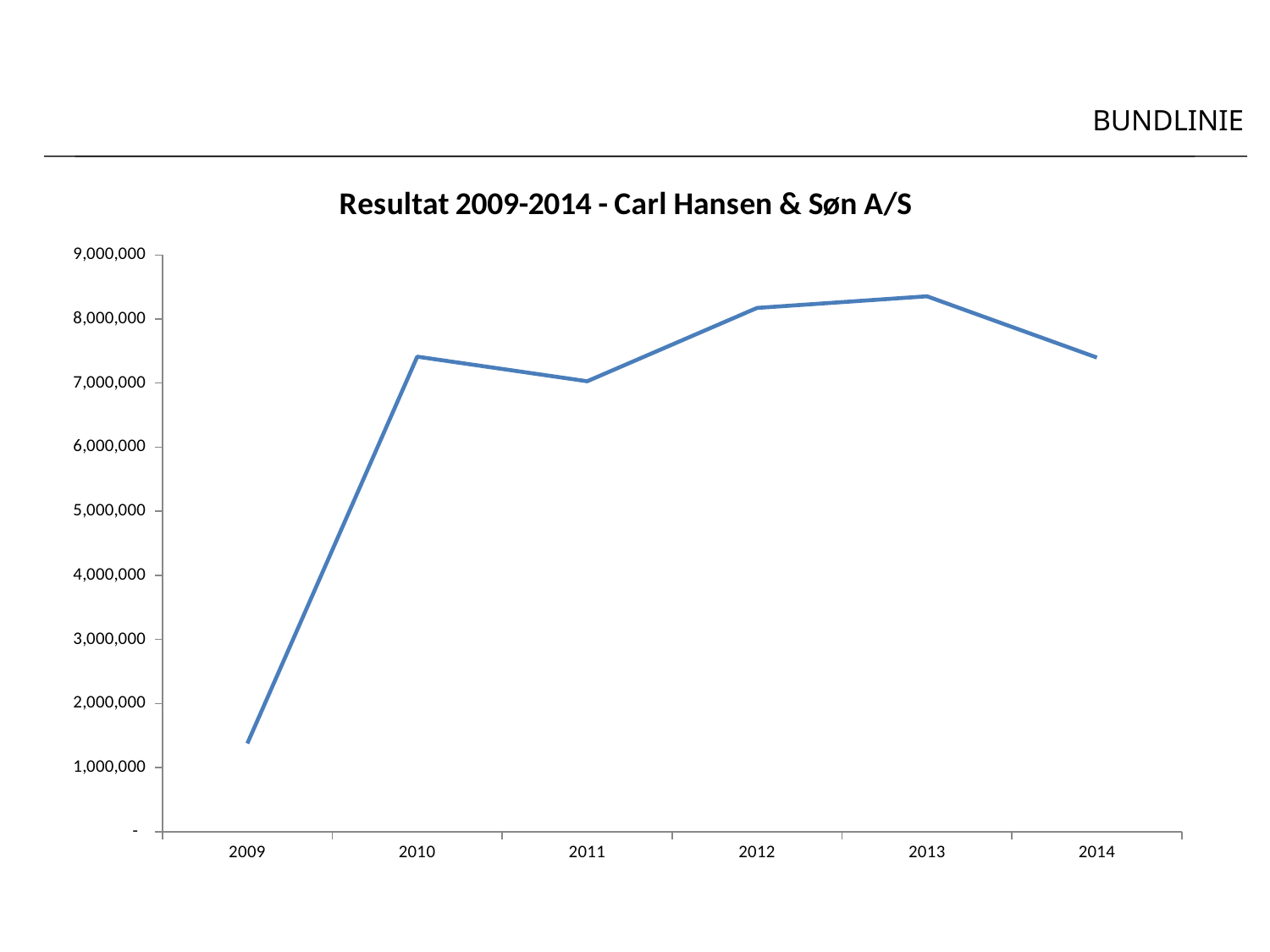
Does the value rise or fall from 2013 to 2014? fall How many years are plotted on the x axis? 6 What is the title of the chart? Resultat 2009-2014 - Carl Hansen & Søn A/S What kind of chart is shown on the slide? line chart Is the value for 2012 greater or less than 8,000,000? greater Is the value for 2014 greater or less than 8,000,000? less Is the value for 2010 greater or less than 7,000,000? greater Which year has the highest value? 2013 Which is larger, the value for 2009 or the value for 2010? 2010 Which year has the lowest value? 2009 Which is larger, the value for 2011 or the value for 2012? 2012